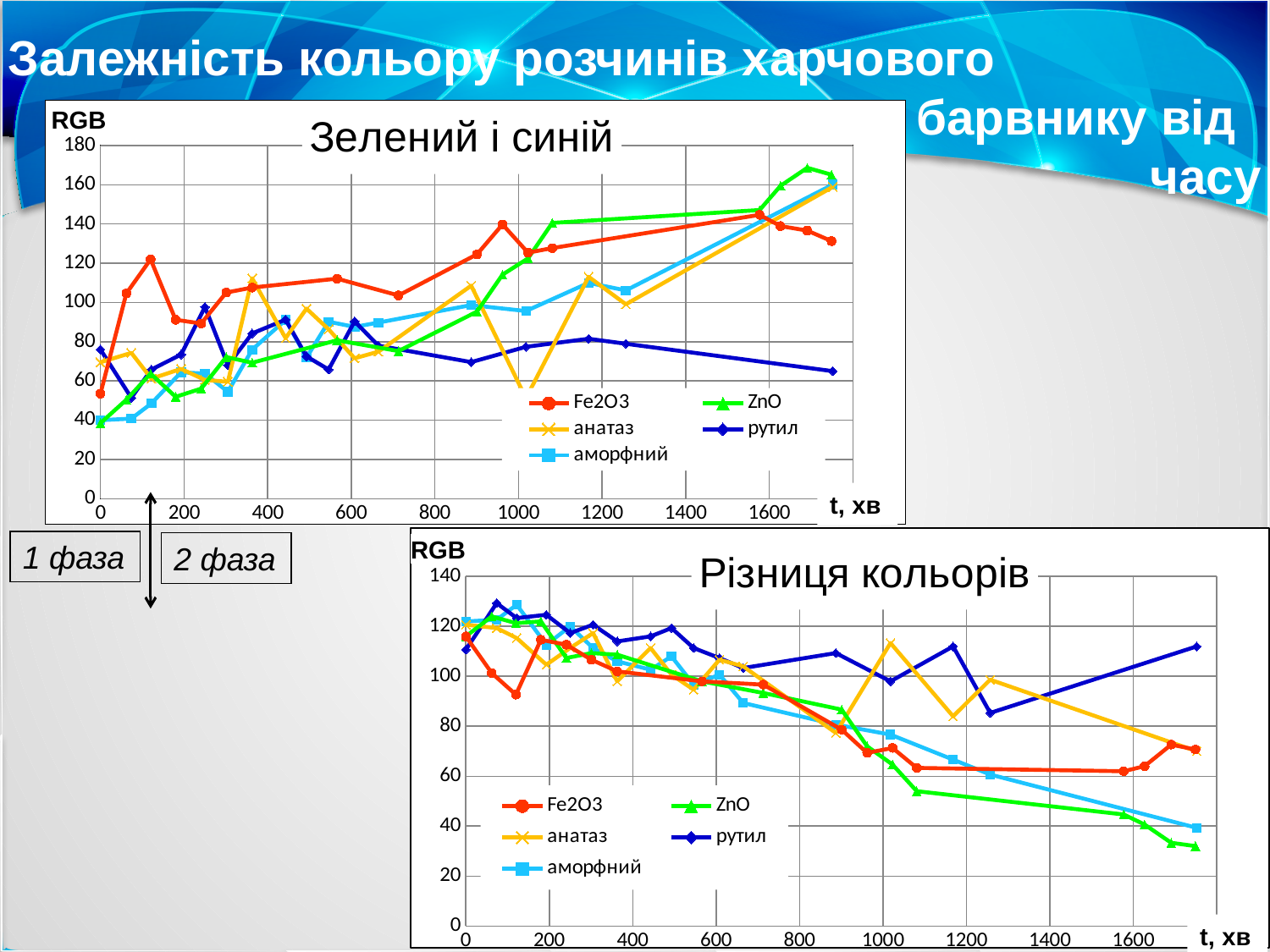
In the top chart "Зелений і синій", does the Fe2O3 series overall rise or fall from t=0 to the last time point? rise What kind of chart is the bottom chart titled "Різниця кольорів"? line chart In the bottom chart "Різниця кольорів", does the ZnO series overall rise or fall along the time axis? fall In the bottom chart "Різниця кольорів", how many series does the legend list? 5 In the bottom chart "Різниця кольорів", is the value for ZnO at the last time point (around 1750) greater or less than 40? less What kind of chart is the top chart titled "Зелений і синій"? line chart In the top chart "Зелений і синій", at the last time point (around 1750), which series is larger: ZnO or рутил? ZnO In the bottom chart "Різниця кольорів", is the value for рутил at the last time point (around 1750) greater or less than 100? greater In the top chart "Зелений і синій", is the value for рутил at the last time point (around 1750) greater or less than 80? less What label is shown on the x axis of both charts? t, хв In the top chart "Зелений і синій", how many series does the legend list? 5